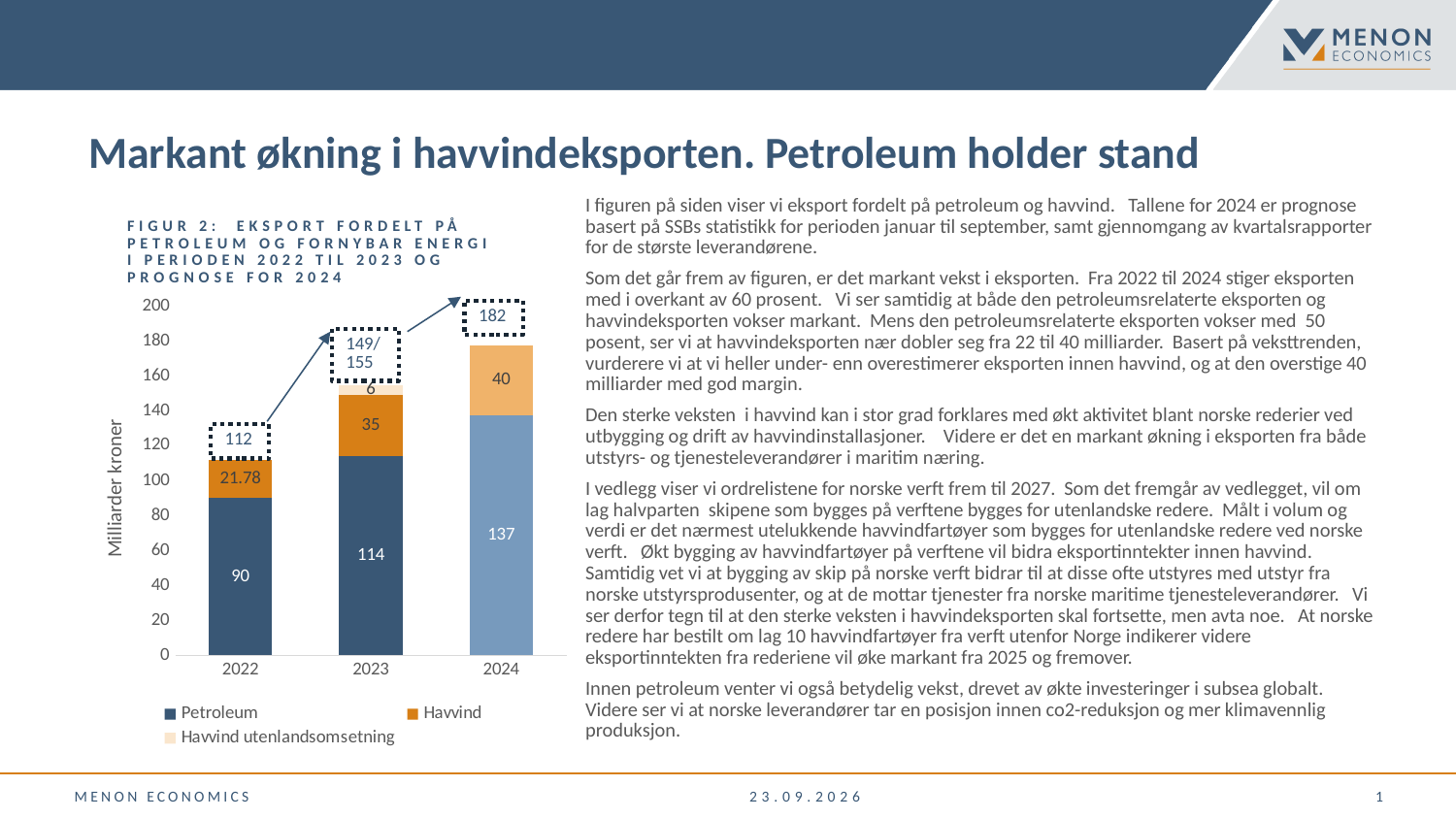
Does the Petroleum value rise or fall from 2022 to 2024? rise What is the Petroleum value for 2022? 90 What is the Havvind utenlandsomsetning value for 2023? 6 What is the Havvind value for 2023? 35 What is the Petroleum value for 2024? 137 How many years are shown on the x axis? 3 What is the difference between the Petroleum value for 2024 and for 2022? 47 What is the Havvind value for 2022? 21.78 What total value is labelled in the dashed box above the 2024 bar? 182 In which year is the Petroleum value highest? 2024 How many series does the legend list? 3 Which year has the larger Havvind value, 2022 or 2023? 2023